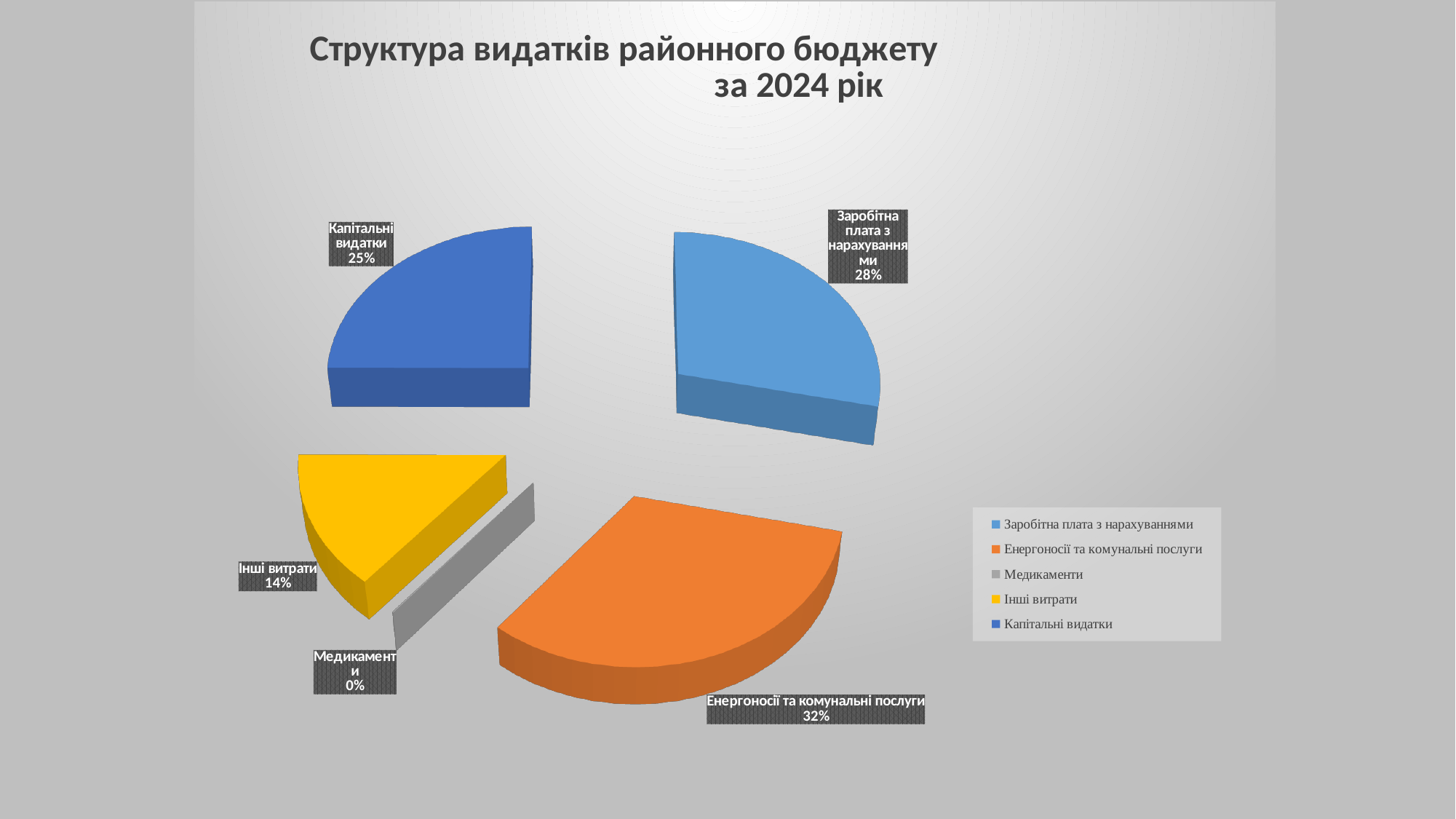
Which category has the largest share of the pie? Енергоносії та комунальні послуги Which is larger, the share for Заробітна плата з нарахуваннями or the share for Інші витрати? Заробітна плата з нарахуваннями What share of the pie is labelled for Медикаменти? 0% What is the difference in percentage points between Енергоносії та комунальні послуги and Капітальні видатки? 7 What share of the pie is labelled for Заробітна плата з нарахуваннями? 28% How many categories does the legend list? 5 What share of the pie is labelled for Енергоносії та комунальні послуги? 32% What is the title of the chart? Структура видатків районного бюджету за 2024 рік What kind of chart is shown on the slide? Pie chart Which category has the smallest share of the pie? Медикаменти